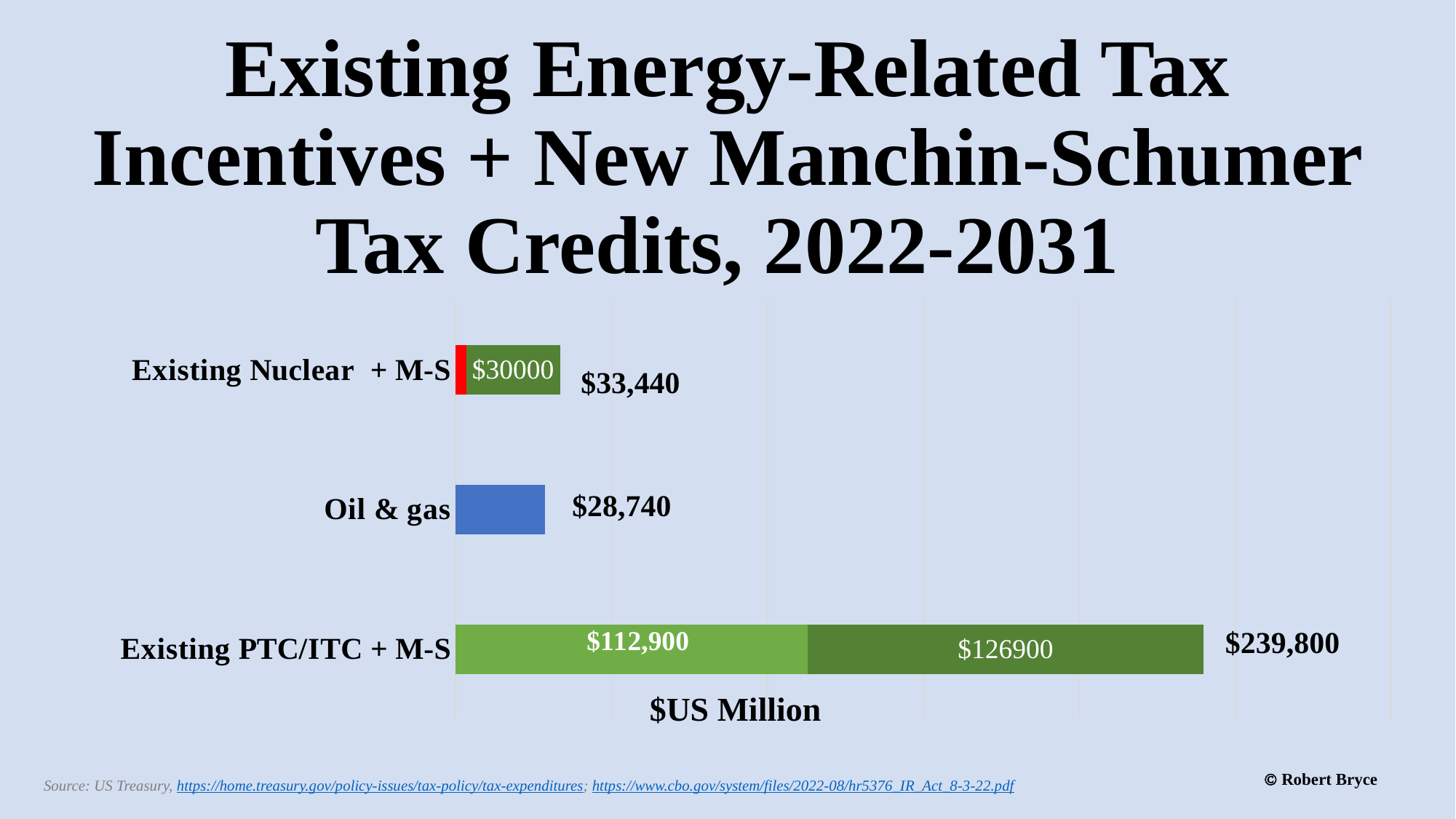
Which is larger, the total for Existing Nuclear + M-S or the total for Oil & gas? Existing Nuclear + M-S What value is printed on the dark green segment of the Existing PTC/ITC + M-S bar? $126900 What is the total value shown for Existing Nuclear + M-S? $33,440 What unit label is shown below the chart's horizontal axis? $US Million What value is printed on the green segment of the Existing Nuclear + M-S bar? $30000 What value is printed on the light green segment of the Existing PTC/ITC + M-S bar? $112,900 What is the difference between the total for Existing PTC/ITC + M-S and the total for Oil & gas? $211,060 Which category has the highest total value? Existing PTC/ITC + M-S Which category has the lowest total value? Oil & gas What is the total value shown for Oil & gas? $28,740 What is the total value shown for Existing PTC/ITC + M-S? $239,800 How many categories are shown on the chart? 3